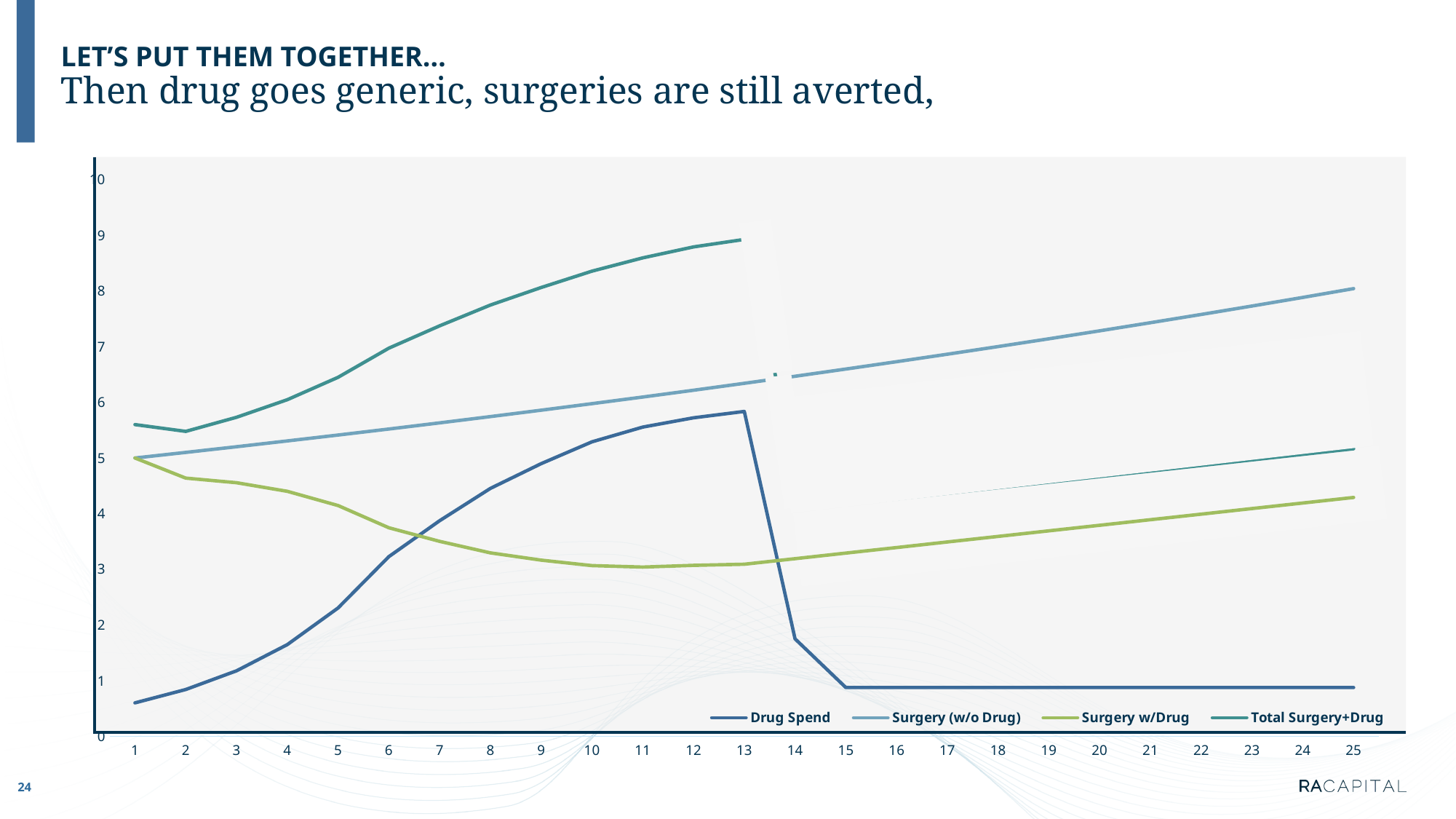
Which series reaches the highest value anywhere on the chart? Total Surgery+Drug Does the Surgery (w/o Drug) line rise or fall as x increases from 1 to 25? Rises Is the value for Surgery w/Drug at x = 11 greater or less than 4? less Is the value for Surgery (w/o Drug) at x = 25 greater or less than 7? greater Which series has the lowest value at x = 25? Drug Spend Is the value for Total Surgery+Drug at x = 13 greater or less than 8? greater How many points are labelled along the x axis? 25 What kind of chart is shown on the slide? Line chart How many series does the legend list? 4 At x = 25, which is higher: Surgery (w/o Drug) or Surgery w/Drug? Surgery (w/o Drug)